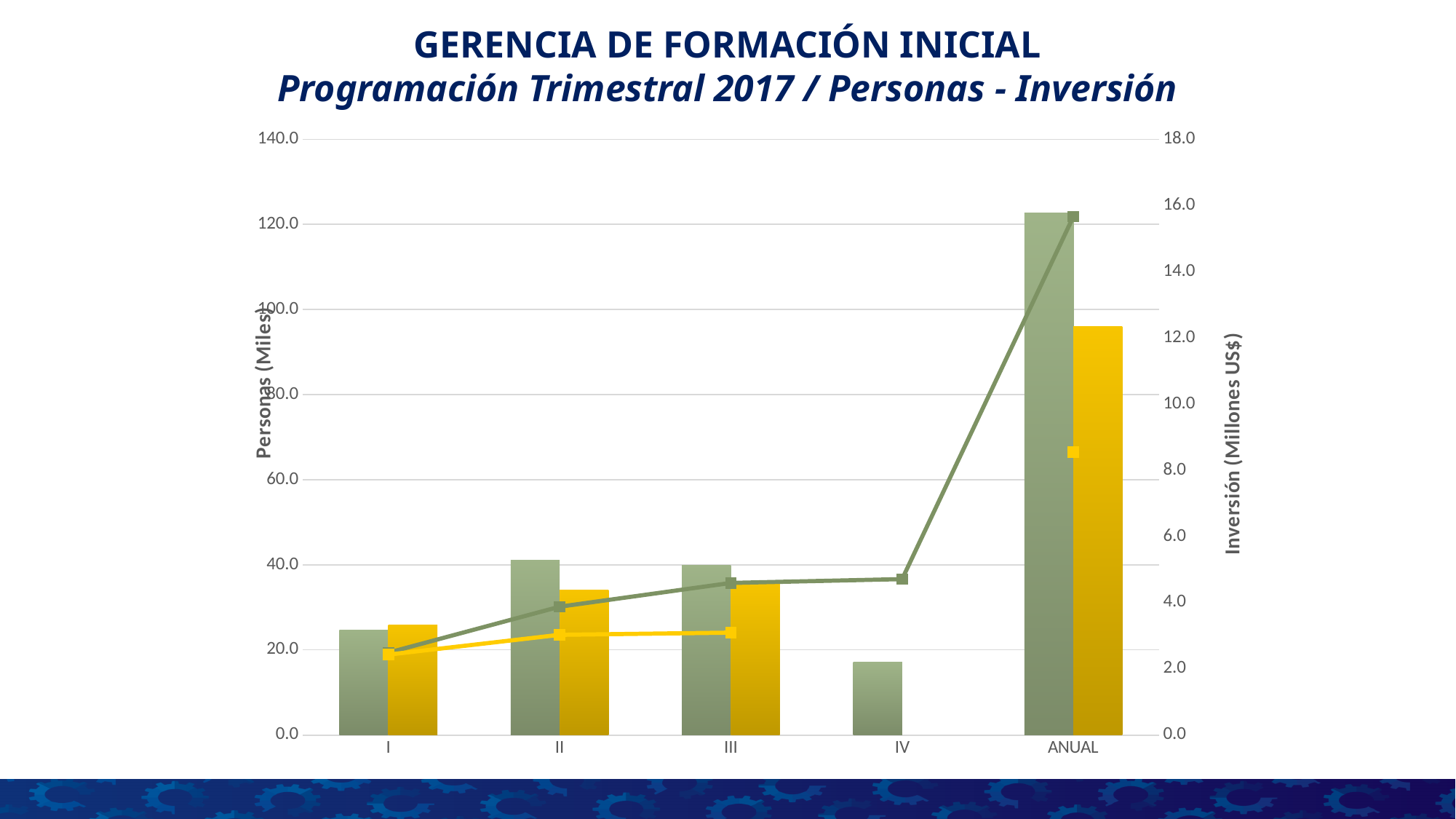
How many categories are shown on the x axis? 5 What is the title of the right vertical axis? Inversión (Millones US$) Which category has the tallest green bar? ANUAL Is the green bar for ANUAL greater or less than 100.0 on the left axis? greater What is the title of the left vertical axis? Personas (Miles) Which is taller, the green bar for II or the green bar for IV? II Does the green line rise or fall from I to ANUAL? Rises What kind of chart is shown on the slide? A combined bar and line chart Is the yellow bar for ANUAL greater or less than 80.0 on the left axis? greater Which category has the shortest green bar? IV Is the green bar for IV greater or less than 20.0 on the left axis? less Which is taller, the yellow bar for ANUAL or the yellow bar for III? ANUAL